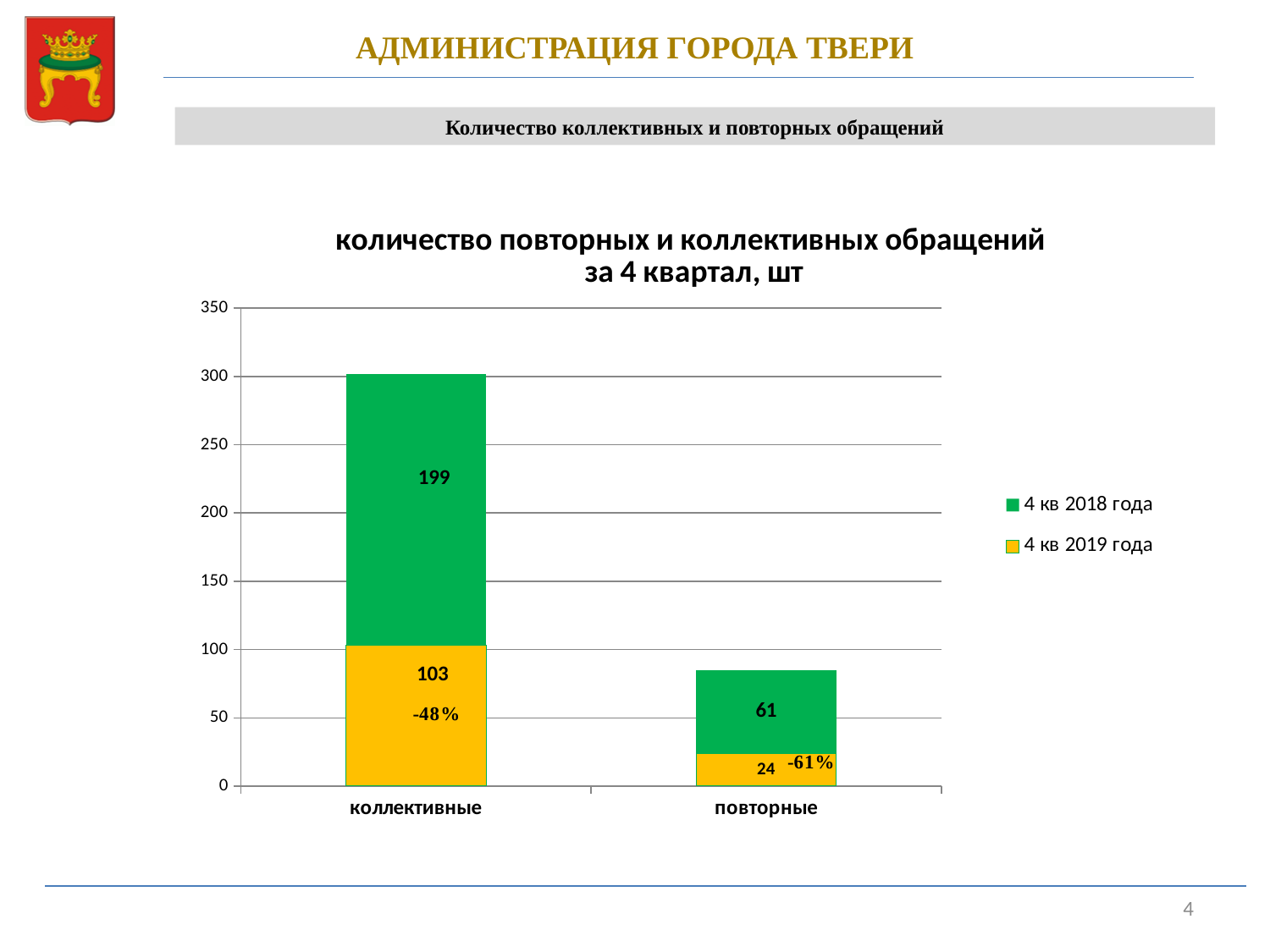
What type of chart is shown on the slide? stacked bar chart What is the value for повторные in the 4 кв 2018 года series? 61 Which category has the higher 4 кв 2019 года value, коллективные or повторные? коллективные What is the value for коллективные in the 4 кв 2018 года series? 199 What is the value for коллективные in the 4 кв 2019 года series? 103 What is the difference between the 4 кв 2018 года and 4 кв 2019 года values for повторные? 37 What is the value for повторные in the 4 кв 2019 года series? 24 What percentage change is shown for повторные? -61% What percentage change is shown for коллективные? -48% How many categories are shown on the x axis? 2 How many series does the legend list? 2 What is the total of the stacked bar for коллективные? 302